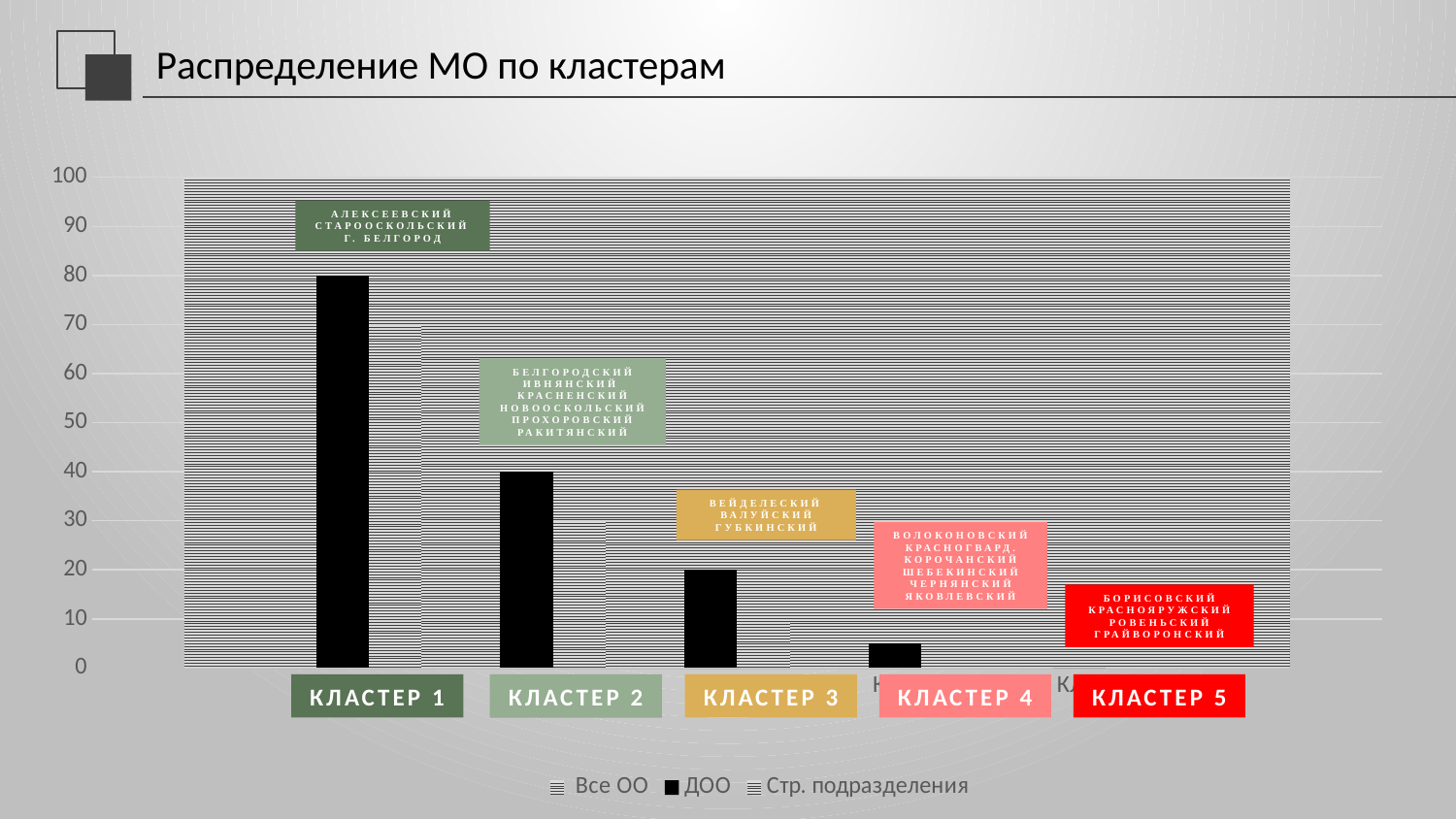
How many series does the legend list? 3 What kind of chart is shown on the slide? bar chart How many clusters (categories) are shown on the x axis? 5 Which cluster has the highest ДОО value? Кластер 1 Which has the larger ДОО value, Кластер 2 or Кластер 3? Кластер 2 Which municipalities are listed in the label above Кластер 3? Вейделеский, Валуйский, Губкинский Is the ДОО value for Кластер 2 greater or less than 50? less Do the ДОО values rise or fall from Кластер 1 to Кластер 4? fall What is the title of the slide? Распределение МО по кластерам Is the ДОО value for Кластер 3 greater or less than 30? less Is the ДОО value for Кластер 4 greater or less than 10? less